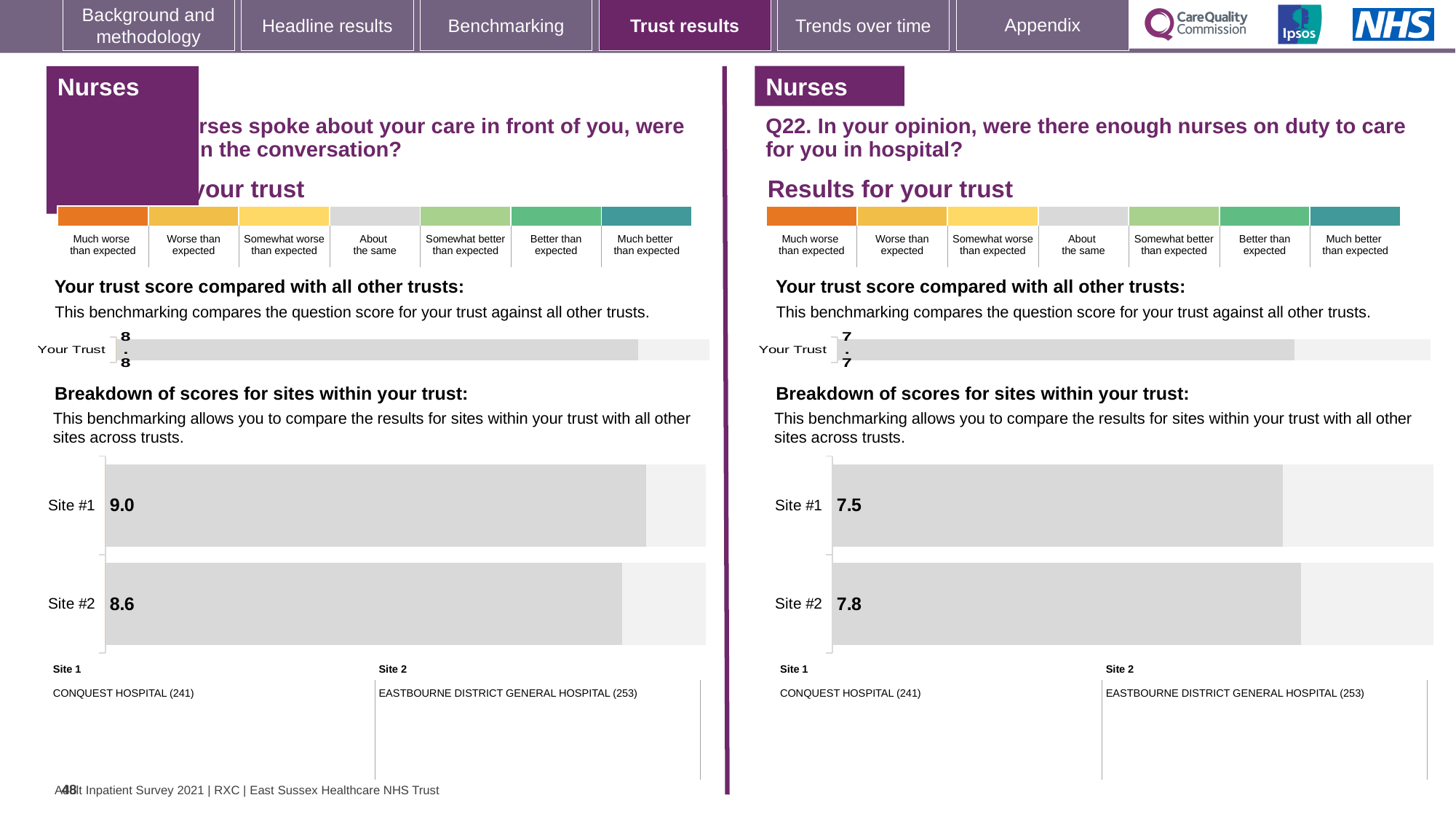
On the right-hand (Q22) site breakdown chart, what is the difference between the Site #2 and Site #1 scores? 0.3 On the left-hand site breakdown chart, what is the difference between the Site #1 and Site #2 scores? 0.4 On the right-hand (Q22) 'Your Trust' bar chart, what is the trust score shown? 7.7 What type of chart is used for the site breakdown on the left-hand side of the slide? Bar chart On the left-hand site breakdown chart, what is the score for Site #2? 8.6 On the right-hand (Q22) site breakdown chart, which site has the lower score? Site #1 On the left-hand site breakdown chart, which site has the higher score? Site #1 How many sites are shown in the right-hand (Q22) site breakdown chart? 2 On the left-hand site breakdown chart, what is the score for Site #1? 9.0 On the right-hand (Q22) site breakdown chart, what is the score for Site #2? 7.8 On the right-hand (Q22) site breakdown chart, what is the score for Site #1? 7.5 On the left-hand 'Your Trust' bar chart, what is the trust score shown? 8.8